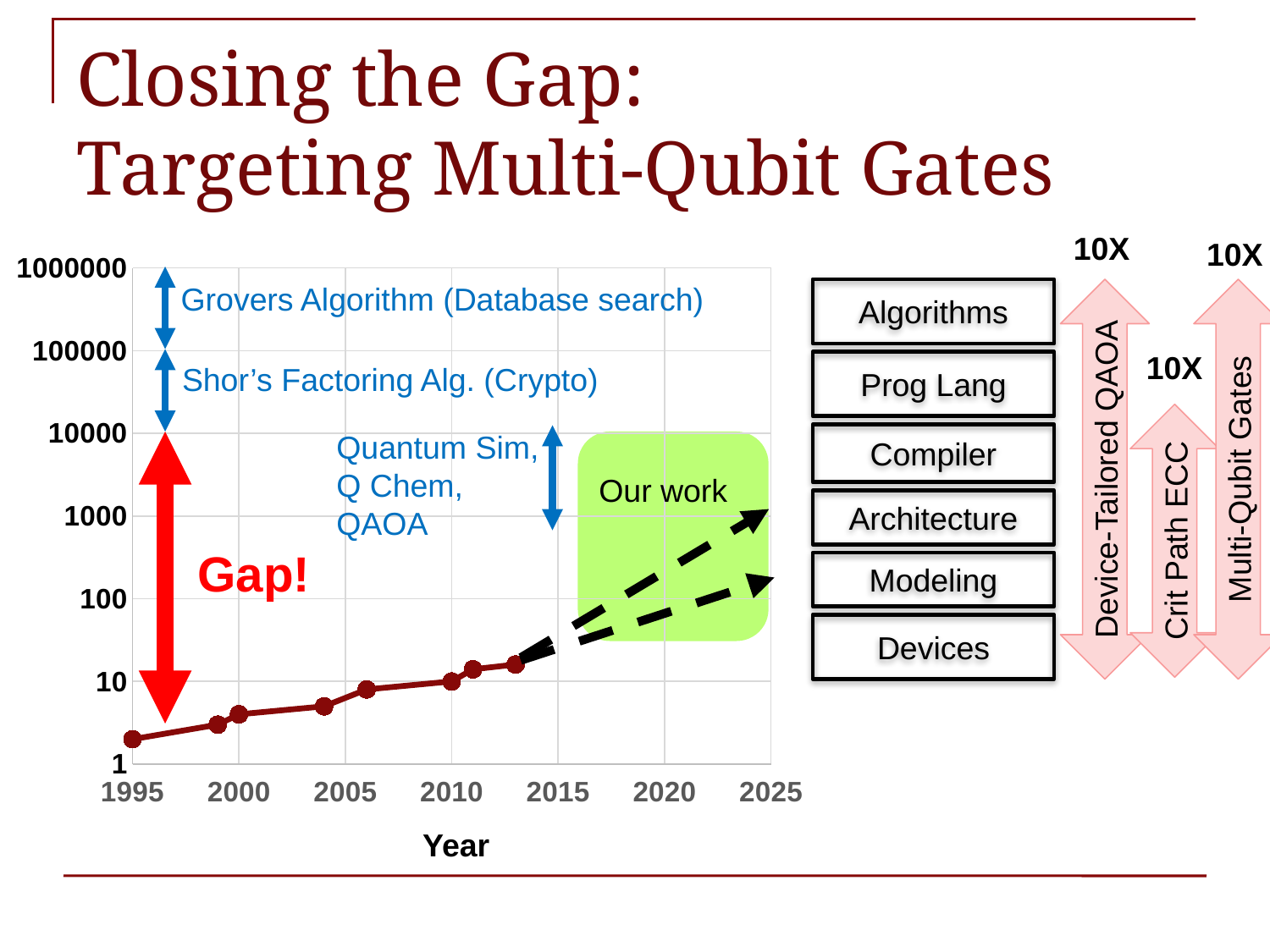
What is the highest value labelled on the y axis of the chart? 1000000 Is the plotted value for 2013 greater or less than 10? greater What is the title of the x axis of the chart? Year Is the plotted value for 2000 greater or less than 10? less Is the plotted value for 1995 greater or less than 10? less How many data points are plotted on the line in the chart? 8 What kind of chart is shown on the slide? line chart Do the plotted values rise or fall as the year increases along the x axis? rise Which year has the lowest plotted value on the line? 1995 Which year has the highest plotted value on the line? 2013 Which has the larger plotted value, 1995 or 2013? 2013